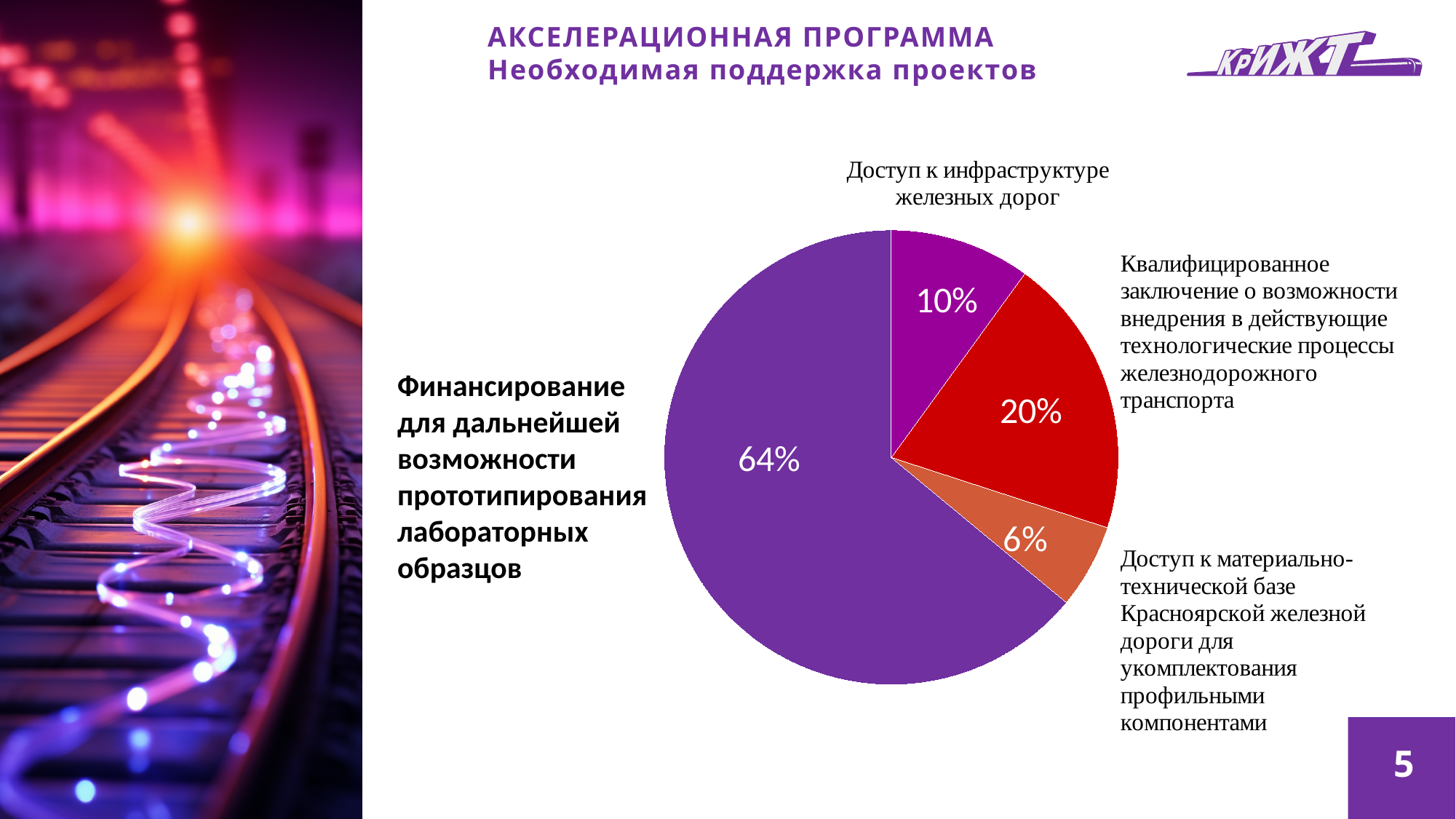
Which category has the smallest slice of the pie? Доступ к материально-технической базе Красноярской железной дороги для укомплектования профильными компонентами Which category has the largest slice of the pie? Финансирование для дальнейшей возможности прототипирования лабораторных образцов What is the combined share of the "Доступ к инфраструктуре железных дорог" and "Доступ к материально-технической базе" slices? 16% What is the difference in percentage points between the "Финансирование" slice and the "Квалифицированное заключение" slice? 44 What share of the pie is labelled "Доступ к материально-технической базе Красноярской железной дороги для укомплектования профильными компонентами"? 6% What share of the pie is labelled "Финансирование для дальнейшей возможности прототипирования лабораторных образцов"? 64% What kind of chart is shown on the slide? Pie chart What is the title of the slide containing the pie chart? АКСЕЛЕРАЦИОННАЯ ПРОГРАММА Необходимая поддержка проектов What share of the pie is labelled "Квалифицированное заключение о возможности внедрения в действующие технологические процессы железнодорожного транспорта"? 20% What share of the pie is labelled "Доступ к инфраструктуре железных дорог"? 10% Which is larger: the slice for "Доступ к инфраструктуре железных дорог" or the slice for "Доступ к материально-технической базе"? Доступ к инфраструктуре железных дорог How many slices does the pie chart have? 4